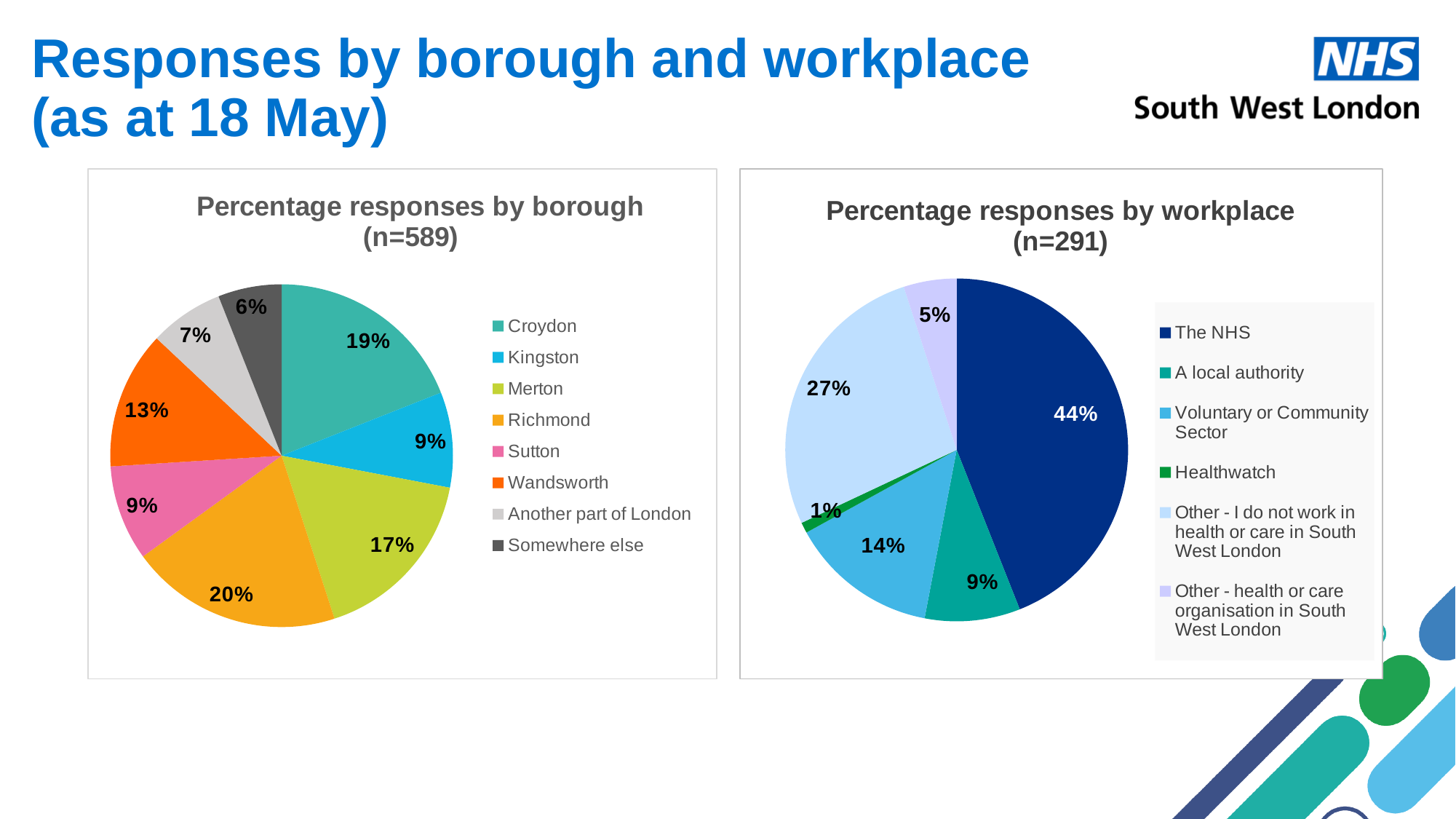
In the 'Percentage responses by borough' chart, what share of responses came from Croydon? 19% In the 'Percentage responses by workplace' chart, what share of responses came from The NHS? 44% In the 'Percentage responses by borough' chart, which category has the smallest slice? Somewhere else In the 'Percentage responses by workplace' chart, what share of responses came from Healthwatch? 1% In the 'Percentage responses by workplace' chart, which is larger: the Voluntary or Community Sector slice or the A local authority slice? Voluntary or Community Sector In the 'Percentage responses by workplace' chart, what is the difference between The NHS share and the share for 'Other - I do not work in health or care in South West London'? 17% In the 'Percentage responses by borough' chart, how many categories does the legend list? 8 In the 'Percentage responses by borough' chart, what is the difference between the Wandsworth share and the Sutton share? 4% What is the sample size (n) shown in the title of the 'Percentage responses by workplace' chart? 291 What kind of chart is the 'Percentage responses by workplace' chart? Pie chart In the 'Percentage responses by borough' chart, which borough has the largest slice? Richmond